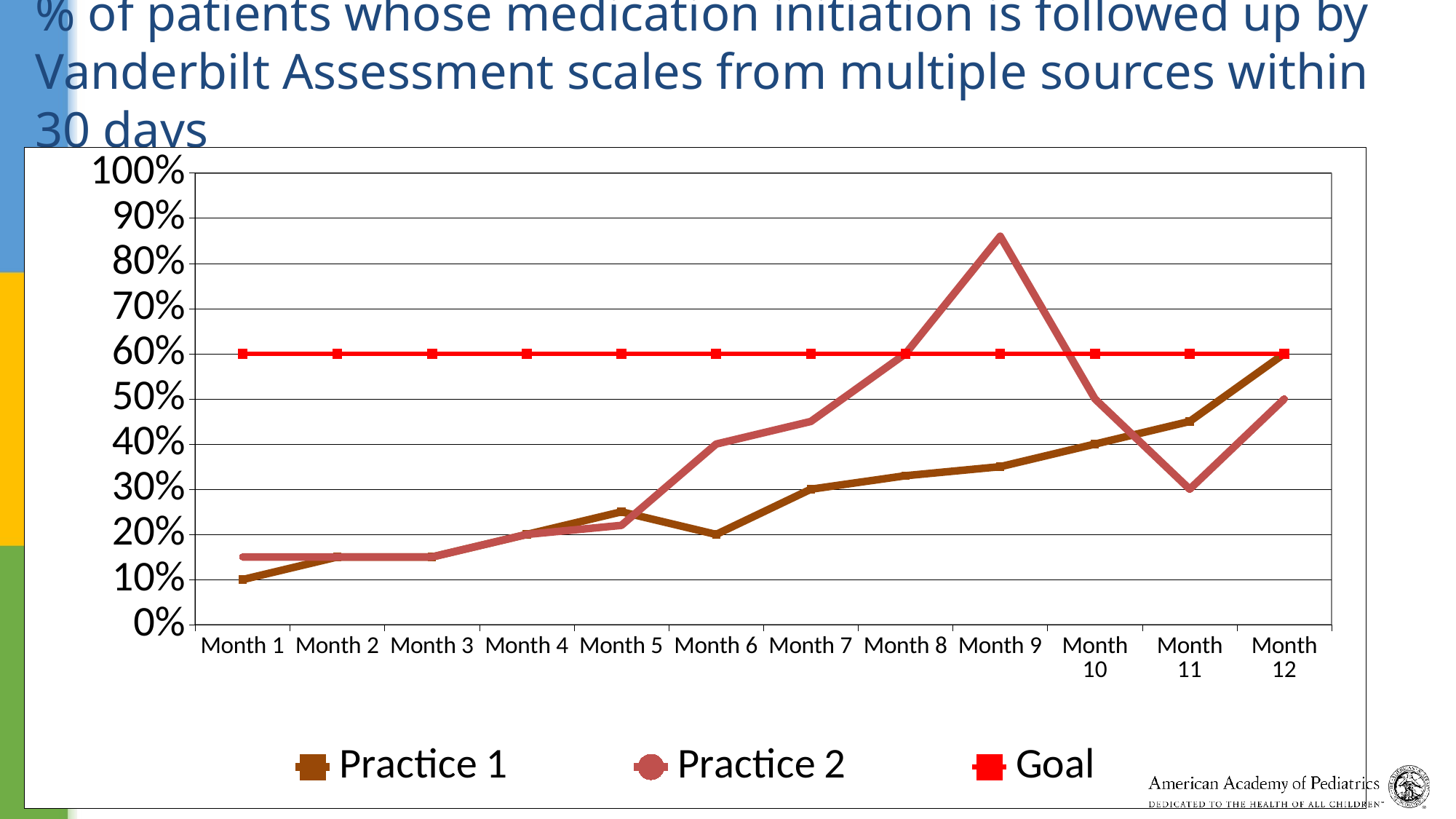
What is the value for Practice 2 at Month 11? 30% What kind of chart is shown on the slide? line chart What is the value for Practice 1 at Month 12? 60% What is the value for Practice 1 at Month 1? 10% Which series is drawn as a flat red line with square markers? Goal What is the value of the Goal line at Month 5? 60% How many series does the legend list? 3 How many months are shown on the x axis? 12 Is the value for Practice 2 at Month 9 greater or less than 80%? greater Does the Practice 1 line generally rise or fall from Month 7 to Month 12? rise In which month does Practice 2 reach its highest value? Month 9 At Month 11, which is larger, Practice 1 or Practice 2? Practice 1